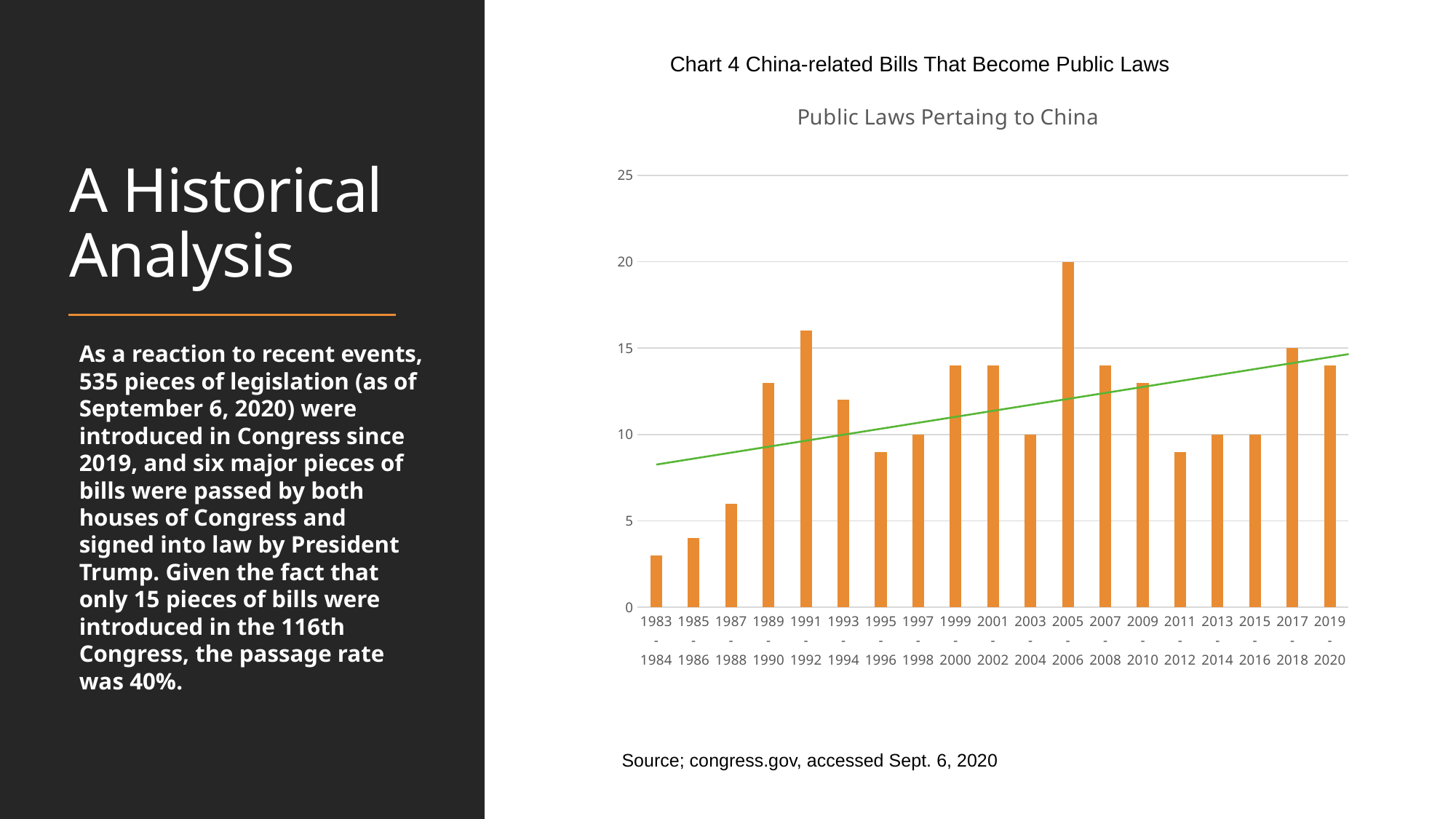
Which is larger, the value for 1983-1984 or the value for 1987-1988? 1987-1988 What is the value for 2017-2018? 15 According to the green trend line, do the values generally rise or fall from 1983-1984 to 2019-2020? rise Is the value for 1991-1992 greater or less than 15? greater What is the difference between the values for 2005-2006 and 2017-2018? 5 What kind of chart is shown on the slide? bar chart Is the value for 1985-1986 greater or less than 5? less Which period has the lowest number of public laws? 1983-1984 What is the title of the chart? Public Laws Pertaing to China How many year-pair categories are shown on the x axis? 19 Which period has the highest number of public laws? 2005-2006 What is the value for 2005-2006? 20